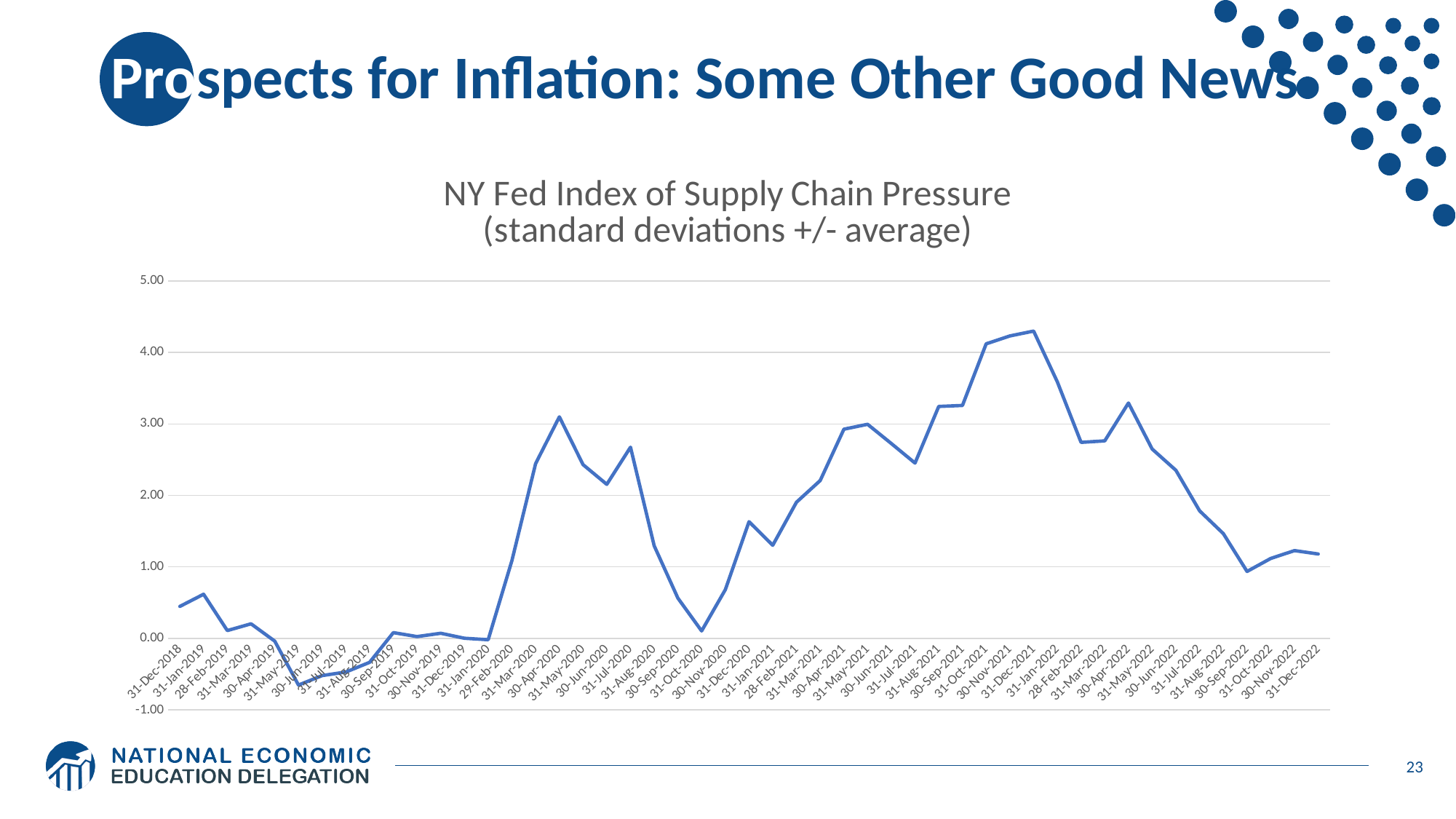
What kind of chart is shown on the slide? Line chart Does the index generally rise or fall between 31-Oct-2020 and 31-Dec-2021? rise Is the value for 31-Mar-2020 greater or less than 2.00? greater Which date has the larger value, 31-Oct-2020 or 31-Dec-2022? 31-Dec-2022 Which date has the larger value, 31-Dec-2021 or 30-Apr-2020? 31-Dec-2021 Is the value for 31-Oct-2020 greater or less than 1.00? less How many data series are plotted on the chart? 1 What is the title of the chart? NY Fed Index of Supply Chain Pressure (standard deviations +/- average) At which date does the NY Fed Index of Supply Chain Pressure reach its highest value? 31-Dec-2021 Is the value for 31-Dec-2018 greater or less than 1.00? less Does the index generally rise or fall between 31-Dec-2021 and 30-Sep-2022? fall